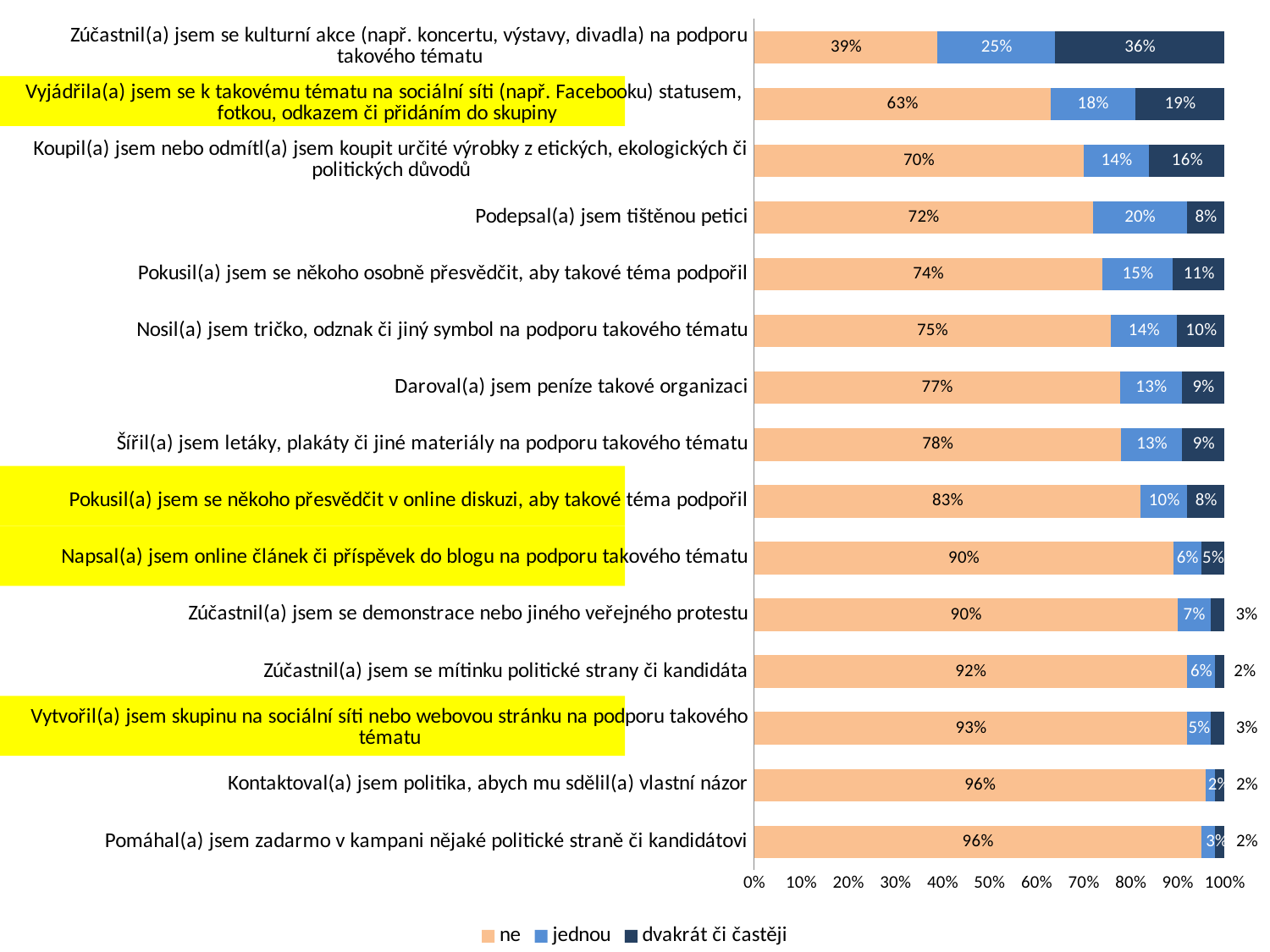
What is the value of "jednou" for "Zúčastnil(a) jsem se kulturní akce (např. koncertu, výstavy, divadla) na podporu takového tématu"? 25% How many series does the legend list? 3 Which category has the highest value for "dvakrát či častěji"? Zúčastnil(a) jsem se kulturní akce (např. koncertu, výstavy, divadla) na podporu takového tématu What is the value of "ne" for "Podepsal(a) jsem tištěnou petici"? 72% What is the difference between the "ne" values for "Daroval(a) jsem peníze takové organizaci" and "Koupil(a) jsem nebo odmítl(a) jsem koupit určité výrobky z etických, ekologických či politických důvodů"? 7% Which category has the lowest value for "ne"? Zúčastnil(a) jsem se kulturní akce (např. koncertu, výstavy, divadla) na podporu takového tématu Which is larger: the "jednou" value for "Podepsal(a) jsem tištěnou petici" or for "Pokusil(a) jsem se někoho osobně přesvědčit, aby takové téma podpořil"? Podepsal(a) jsem tištěnou petici What is the total of the stacked bar for "Nosil(a) jsem tričko, odznak či jiný symbol na podporu takového tématu"? 99% What is the value of "dvakrát či častěji" for "Vyjádřila(a) jsem se k takovému tématu na sociální síti (např. Facebooku) statusem, fotkou, odkazem či přidáním do skupiny"? 19% What kind of chart is shown on the slide? stacked bar chart How many categories (statements) are plotted in the chart? 15 Which legend entry is shown in the darkest colour? dvakrát či častěji